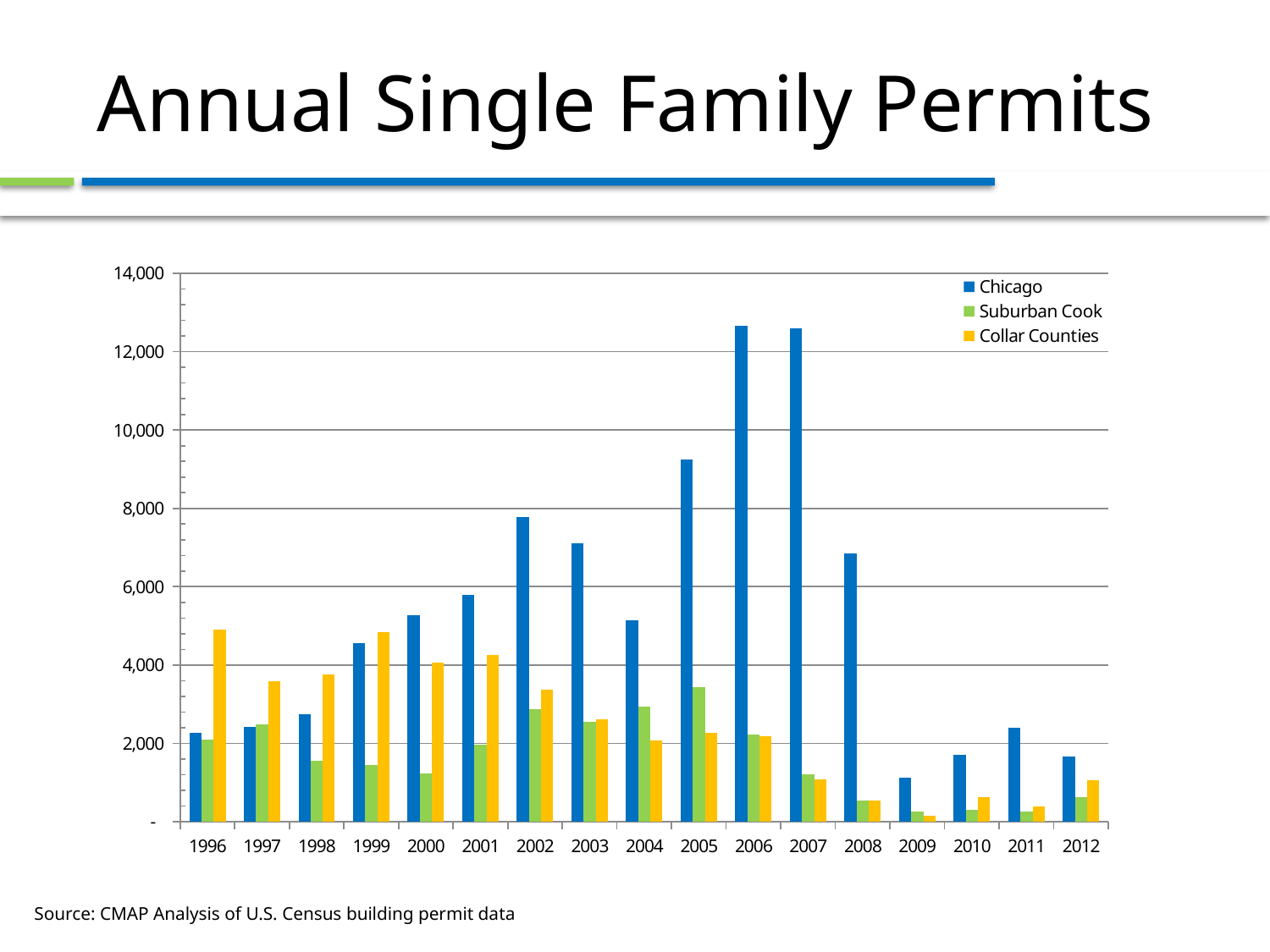
In which year is the Collar Counties value lowest? 2009 What colour represents Collar Counties in the legend? yellow Is the value for Collar Counties in 1996 greater or less than 4,000? greater How many years are shown on the x axis? 17 In 1996, which is larger: Chicago or Collar Counties? Collar Counties Is the value for Chicago in 2005 greater or less than 8,000? greater Is the value for Suburban Cook in 2008 greater or less than 1,000? less Do the Chicago values rise or fall from 2007 to 2009? fall What kind of chart is shown on the slide? bar chart How many series does the legend list? 3 In which year is the Suburban Cook value highest? 2005 In 2002, which is larger: Chicago or Collar Counties? Chicago